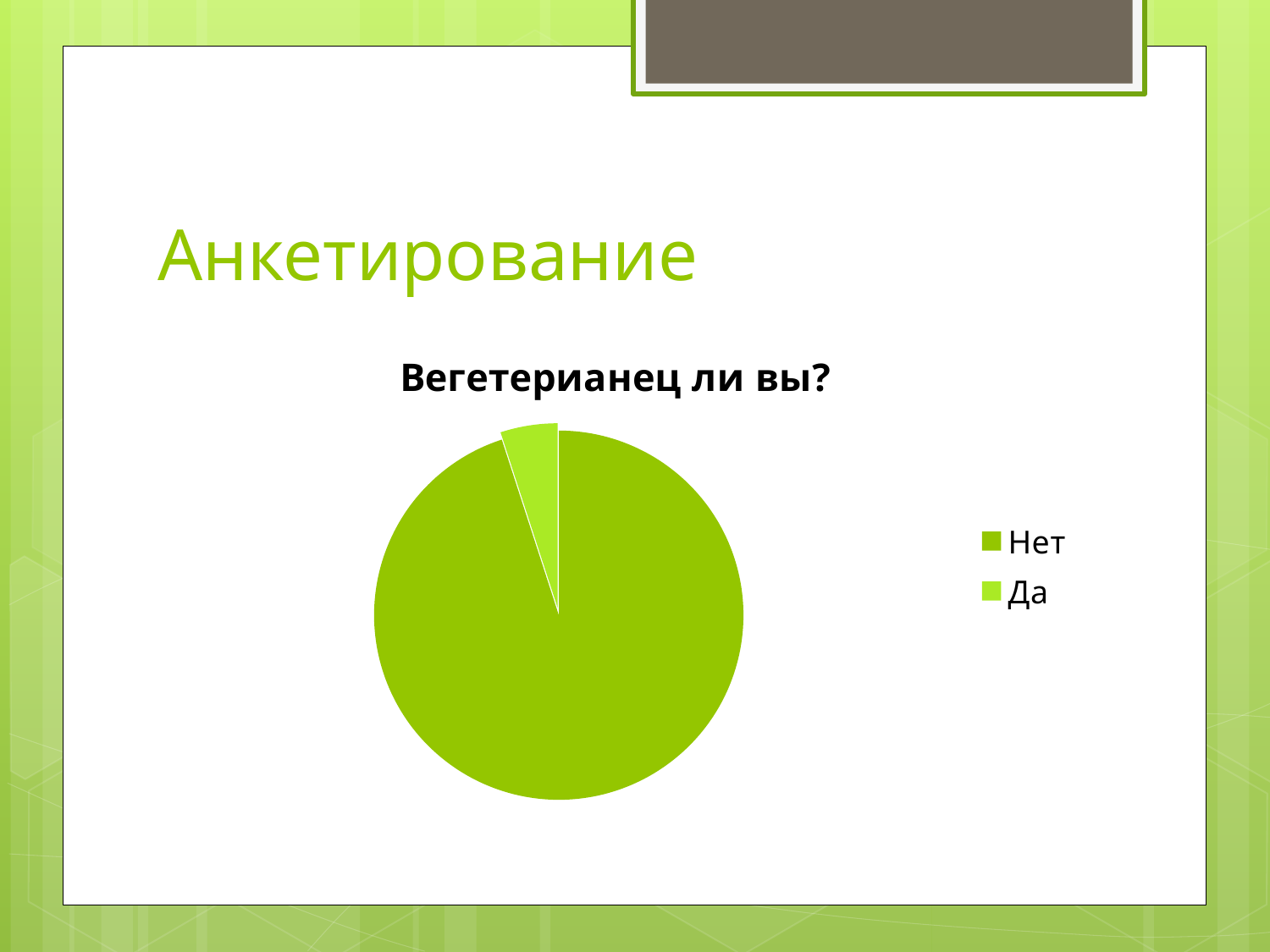
Which category has the largest slice of the pie? Нет What kind of chart is shown on the slide? pie chart Which legend entry is listed first? Нет What is the title of the chart? Вегетерианец ли вы? How many categories does the pie chart have? 2 How many entries does the legend list? 2 Which slice is larger, Нет or Да? Нет Which category has the smallest slice of the pie? Да